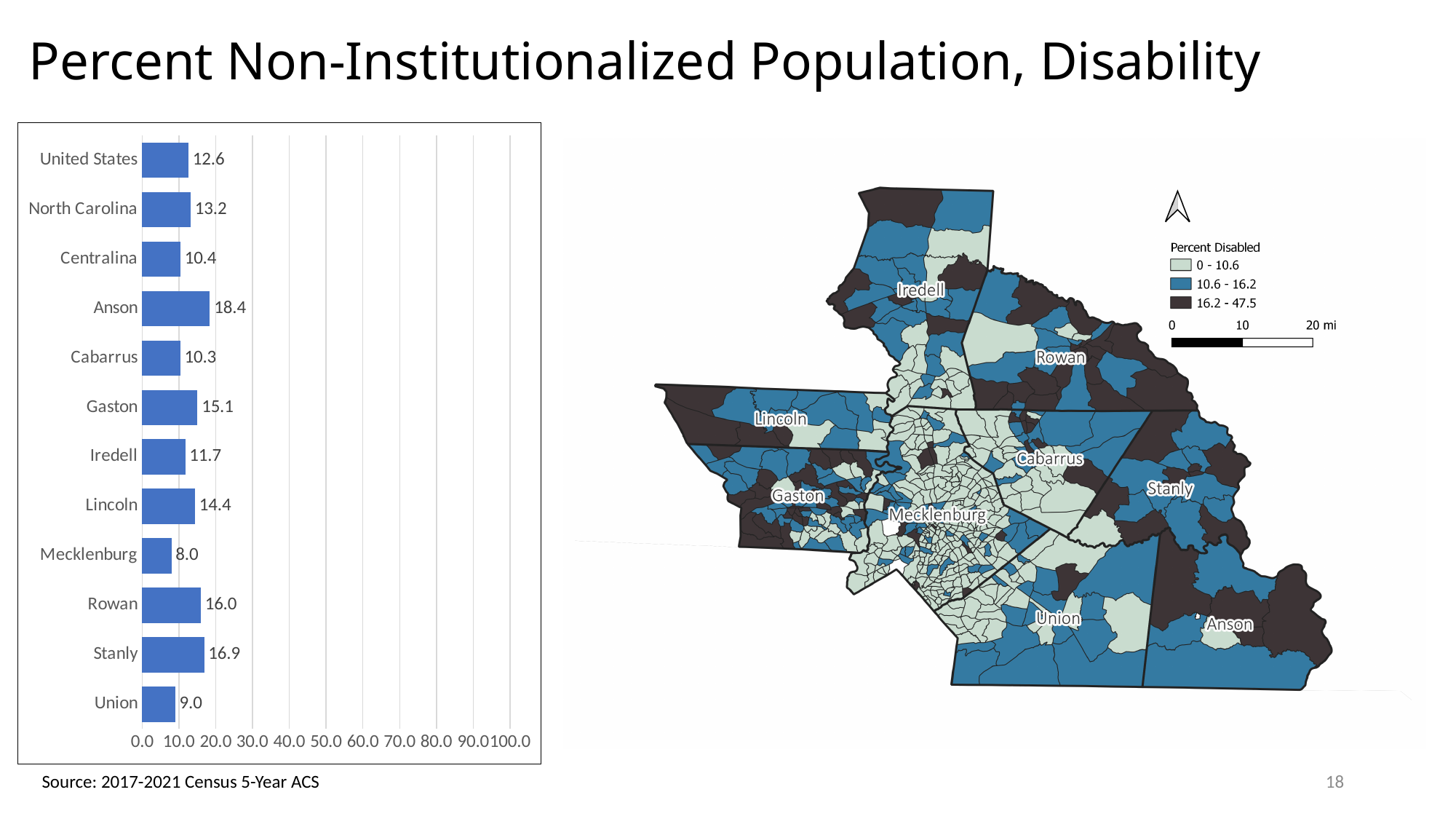
What kind of chart is on the left of the slide? Bar chart Is the value for Lincoln in the bar chart greater or less than 10.0? greater Which category has the lowest value in the bar chart? Mecklenburg What is the value for Anson in the bar chart? 18.4 What is the difference between the values for Stanly and Union in the bar chart? 7.9 How many categories are shown in the bar chart? 12 What is the value for Mecklenburg in the bar chart? 8.0 Which category has the highest value in the bar chart? Anson What is the maximum value shown on the x axis of the bar chart? 100.0 What is the value for North Carolina in the bar chart? 13.2 Which has a larger value in the bar chart, Rowan or Gaston? Rowan What is the difference between the values for United States and Centralina in the bar chart? 2.2